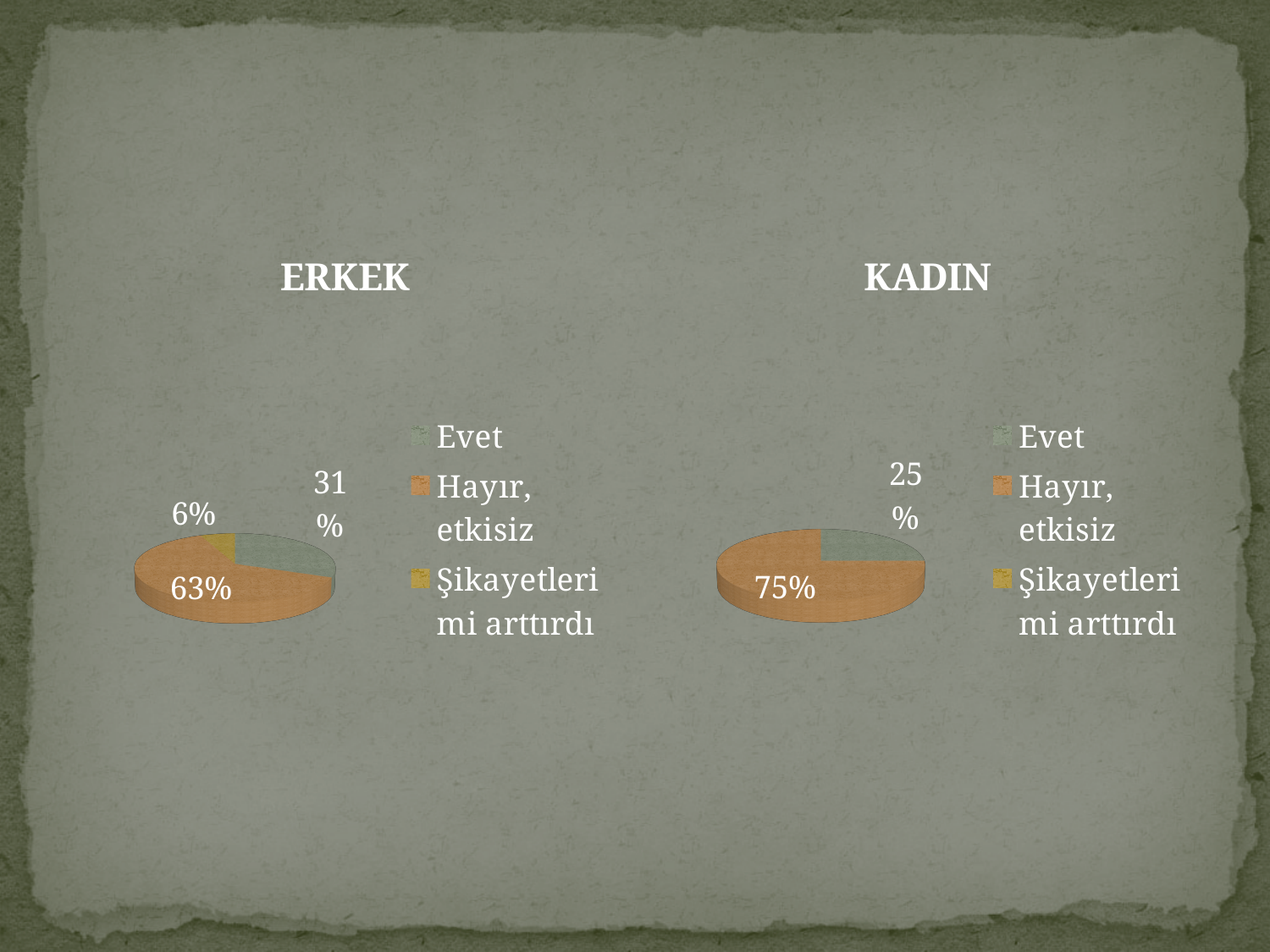
In the ERKEK chart, what percentage is shown for Evet? 31% In the ERKEK chart, what is the difference between the Hayır, etkisiz and Evet percentages? 32% In the KADIN chart, which category has the largest slice? Hayır, etkisiz In the ERKEK chart, what percentage is shown for Hayır, etkisiz? 63% In the KADIN chart, what percentage is shown for Evet? 25% In the KADIN chart, what percentage is shown for Hayır, etkisiz? 75% What type of chart is the ERKEK chart? Pie chart In the ERKEK chart, which category has the smallest slice? Şikayetleri mi arttırdı In the ERKEK chart, which category has the largest slice? Hayır, etkisiz In the ERKEK chart, what percentage is shown for Şikayetleri mi arttırdı? 6% Which chart shows a larger percentage for Evet, ERKEK or KADIN? ERKEK How many entries does the legend of the KADIN chart list? 3